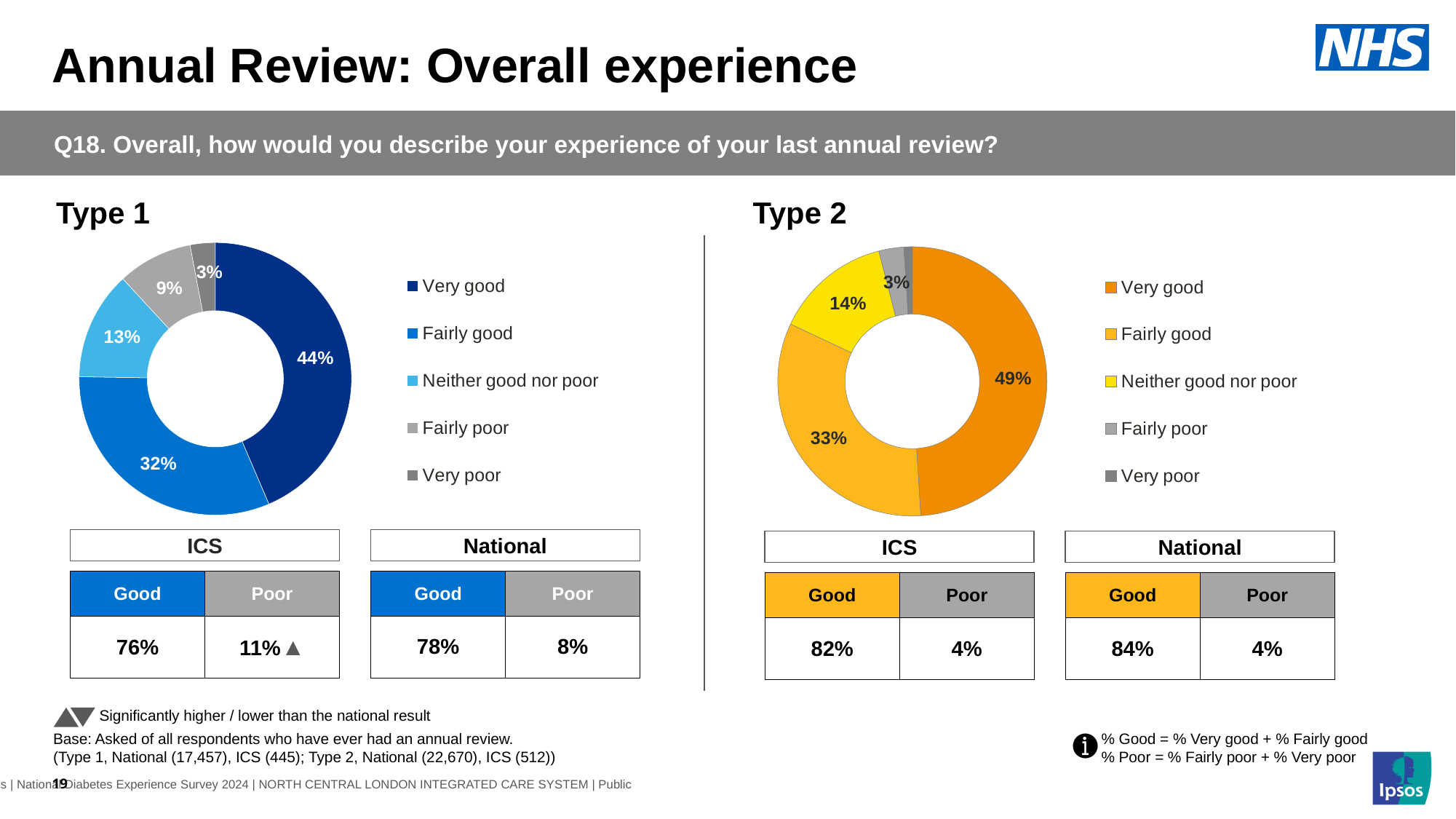
In the Type 1 chart, what is the difference between the Very good and Fairly good shares? 12 percentage points What kind of chart is used for Type 1? Donut (pie) chart In the Type 1 chart, what percentage said Neither good nor poor? 13% In the Type 2 chart, what percentage said Fairly poor? 3% In the Type 1 chart, which category has the largest share? Very good How many categories does the legend of the Type 1 chart list? 5 In the Type 2 chart, what percentage of respondents said their experience was Fairly good? 33% In the Type 2 chart, which category has the largest share? Very good In the Type 2 chart, what colour represents Neither good nor poor? Yellow In the Type 1 chart, what percentage of respondents said their experience was Very good? 44% In the Type 1 chart, which category has the smallest share? Very poor Which is larger: the Very good share in the Type 1 chart or the Very good share in the Type 2 chart? Type 2